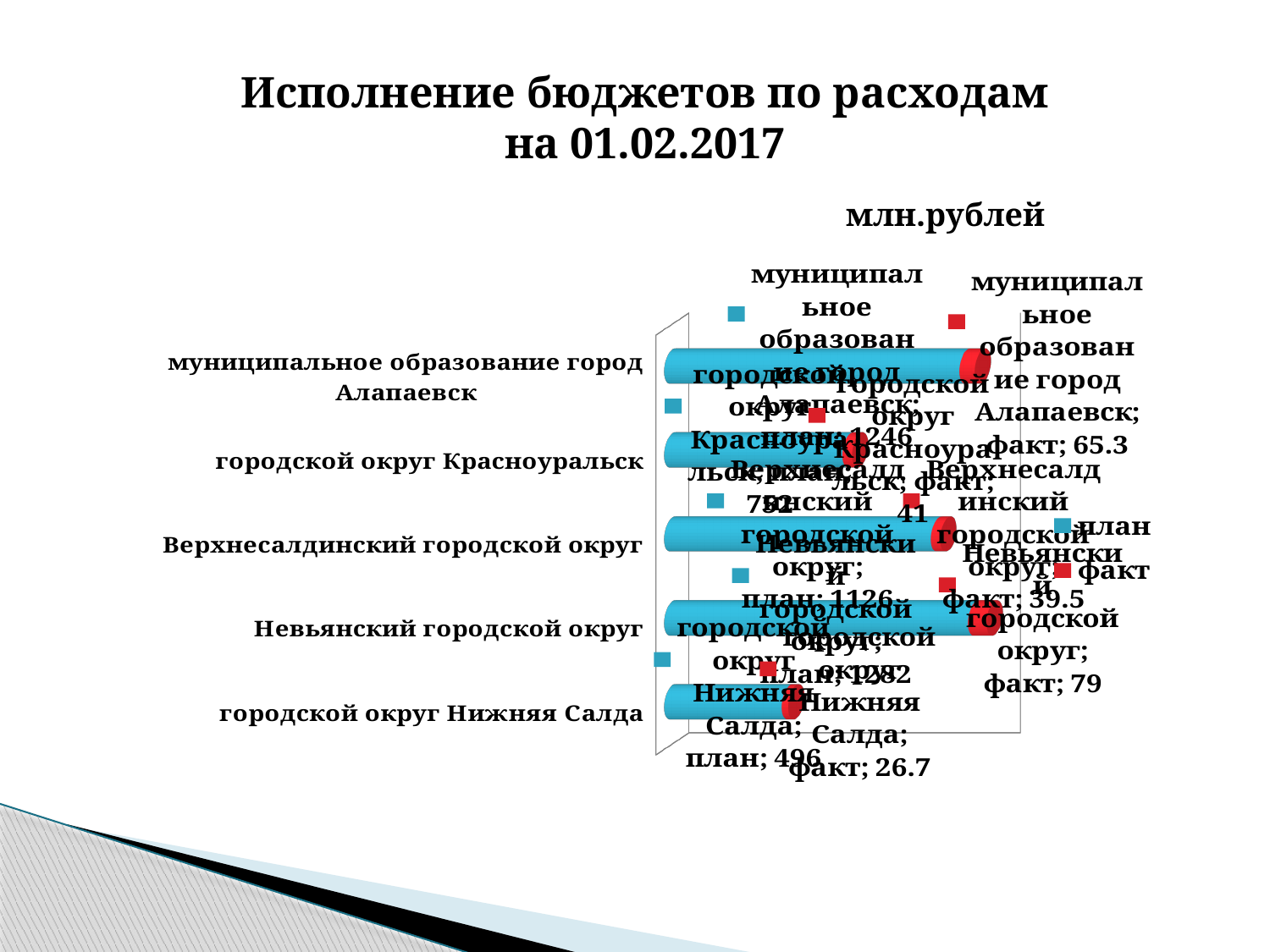
How many series does the legend list? 2 What is the difference between the 'план' and 'факт' values for муниципальное образование город Алапаевск? 1180.7 What unit is stated for the chart values? млн.рублей What is the 'факт' value for городской округ Красноуральск? 41 What is the 'план' value for муниципальное образование город Алапаевск? 1246 What are the two series named in the legend? план, факт What is the 'факт' value for муниципальное образование город Алапаевск? 65.3 What is the 'факт' value for городской округ Нижняя Салда? 26.7 Which category has the highest 'факт' value? Невьянский городской округ What is the 'план' value for Верхнесалдинский городской округ? 1126 What kind of chart is shown on the slide? bar chart How many categories (municipalities) are shown on the chart? 5